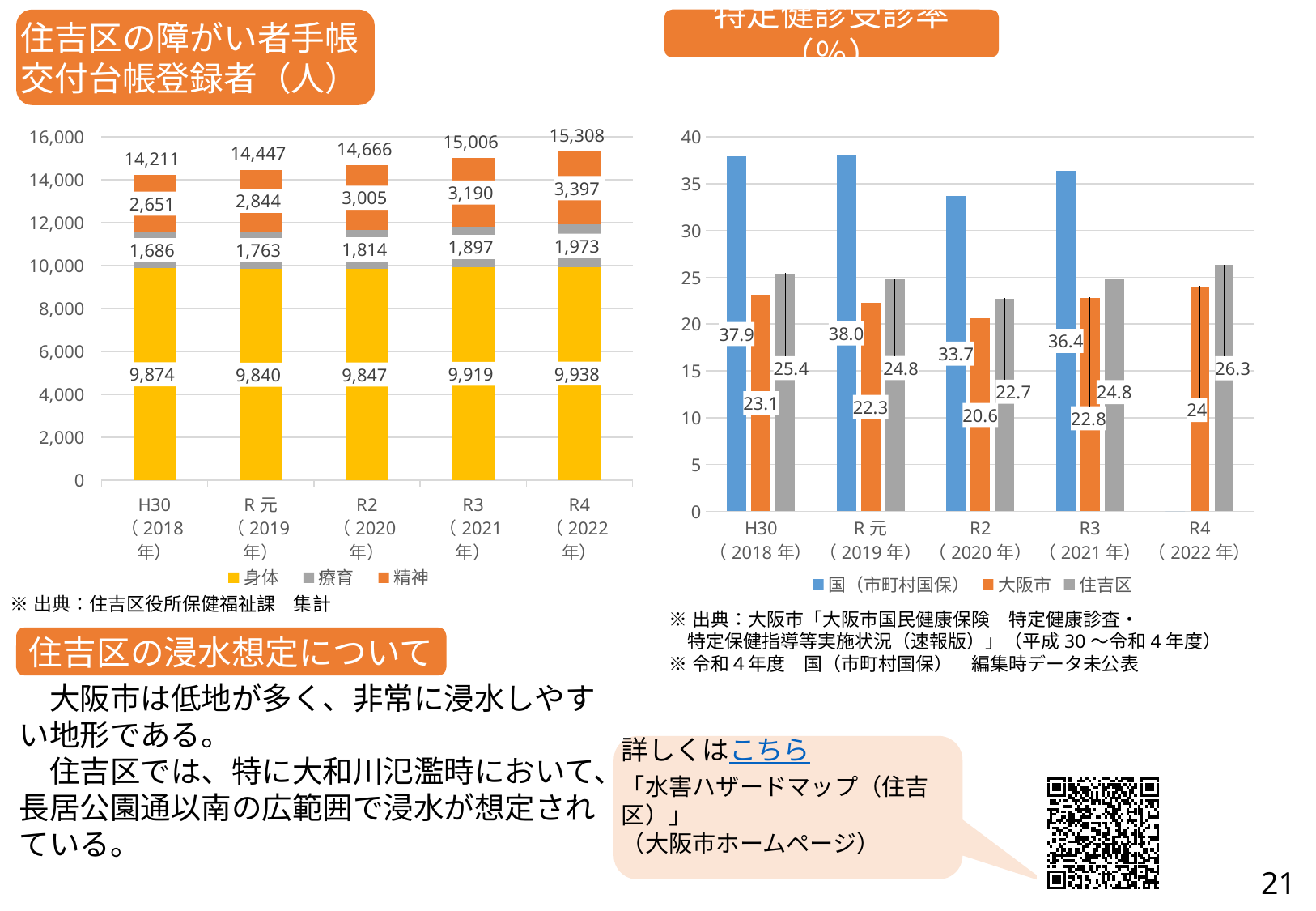
In the left chart (住吉区の障がい者手帳交付台帳登録者), what is the 身体 value for H30（2018年）? 9,874 In the left chart (住吉区の障がい者手帳交付台帳登録者), how much did the 療育 value increase from H30（2018年） to R4（2022年）? 287 In the right chart (特定健診受診率), what is the value for 住吉区 in R4（2022年）? 26.3 In the right chart (特定健診受診率), which year has the lowest value for 大阪市? R2（2020年） In the right chart (特定健診受診率), what is the value for 国（市町村国保） in R元（2019年）? 38.0 In the right chart (特定健診受診率), what is the difference between 国（市町村国保） and 住吉区 in H30（2018年）? 12.5 In the left chart (住吉区の障がい者手帳交付台帳登録者), which year has the highest total? R4（2022年） In the left chart (住吉区の障がい者手帳交付台帳登録者), what is the total for R4（2022年）? 15,308 What type of chart is the right chart (特定健診受診率)? bar chart In the left chart (住吉区の障がい者手帳交付台帳登録者), what is the 精神 value for R2（2020年）? 3,005 In the left chart (住吉区の障がい者手帳交付台帳登録者), do the totals rise or fall from H30 to R4? rise In the left chart (住吉区の障がい者手帳交付台帳登録者), how many series does the legend list? 3